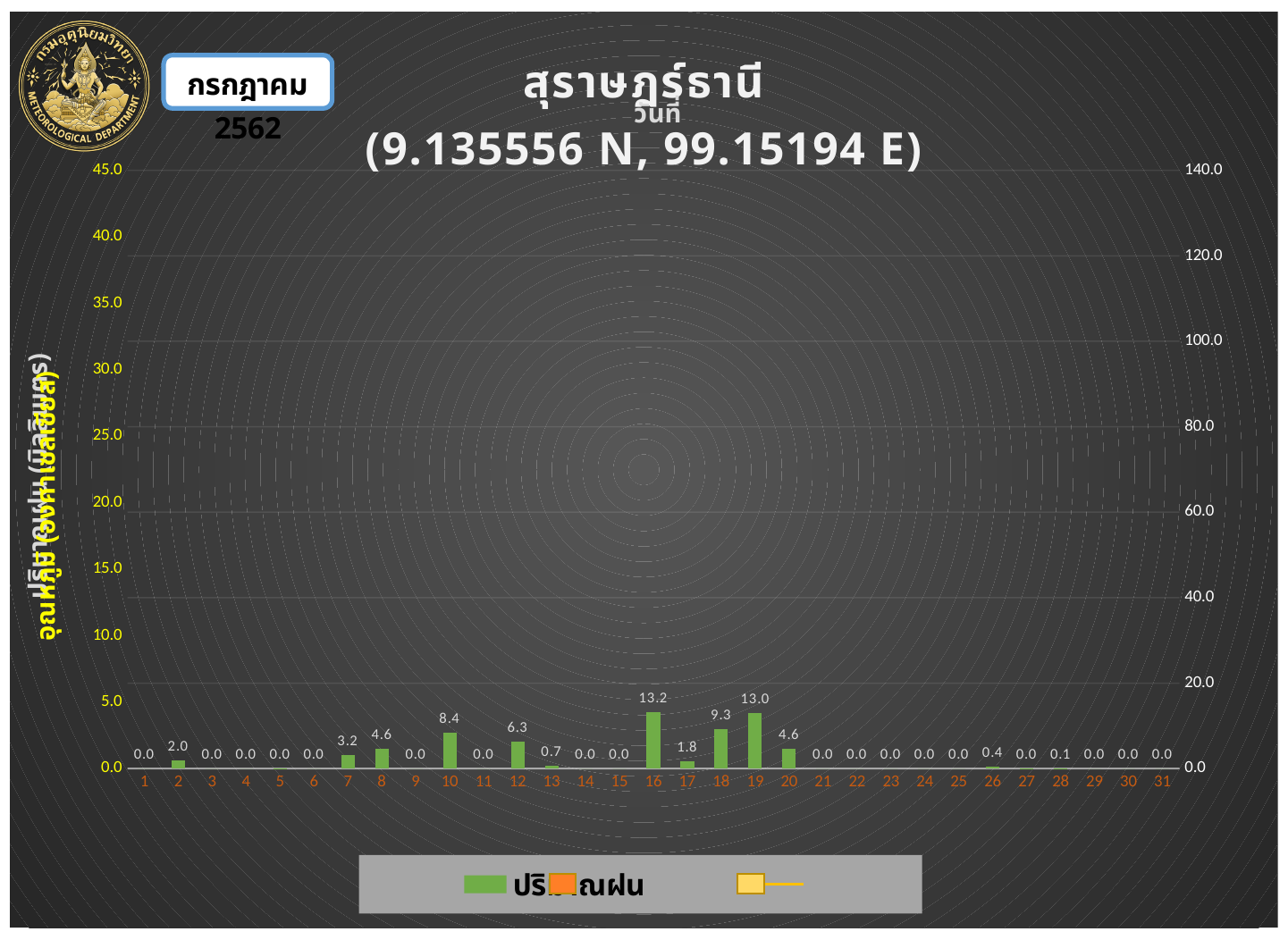
What coordinates are given in the chart title? 9.135556 N, 99.15194 E Which day has the highest rainfall value? 16 What kind of chart is used to show the rainfall values? bar chart How many days are shown on the x axis? 31 What is the difference between the rainfall values for day 10 and day 12? 2.1 What is the rainfall value shown for day 28? 0.1 What is the rainfall value shown for day 10? 8.4 What is the difference between the rainfall values for day 16 and day 19? 0.2 What is the rainfall value shown for day 18? 9.3 Which is larger, the rainfall value for day 7 or for day 8? day 8 Is the rainfall value for day 19 greater or less than 10.0? greater What is the rainfall value shown for day 16? 13.2